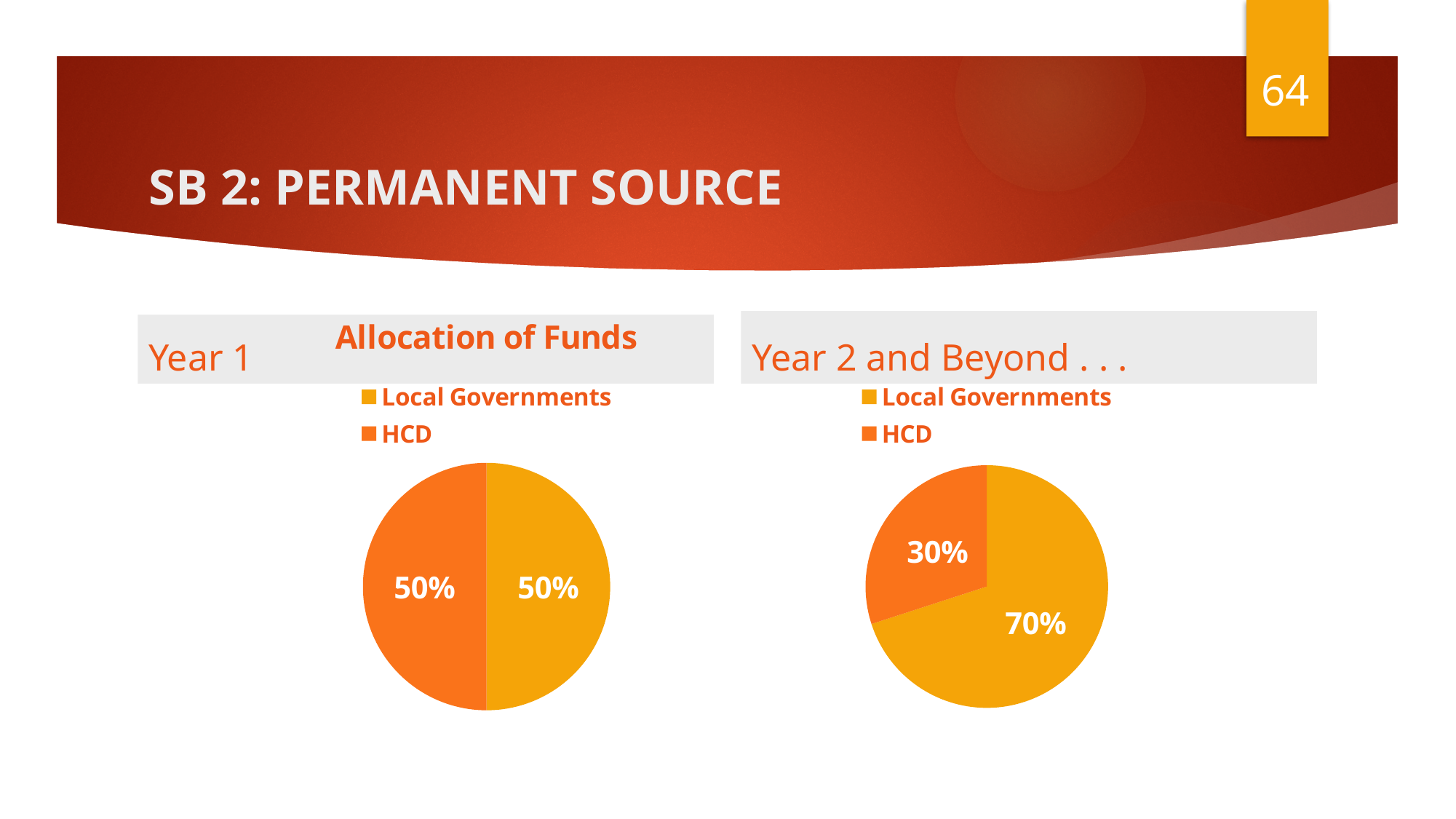
What type of chart is used for the Year 1 allocation? Pie chart How many entries does the legend of the Year 2 and Beyond pie chart list? 2 In the Year 2 and Beyond pie chart, which category receives the smallest share? HCD In the Year 2 and Beyond pie chart, what share of funds goes to HCD? 30% What is the title shown above the Year 1 pie chart? Allocation of Funds In the Year 1 pie chart, what share of funds goes to Local Governments? 50% How many categories does the Year 1 pie chart show? 2 In the Year 2 and Beyond pie chart, which category receives the largest share? Local Governments In the Year 2 and Beyond pie chart, what share of funds goes to Local Governments? 70% In the Year 2 and Beyond pie chart, what is the difference between the Local Governments share and the HCD share? 40% In the Year 1 pie chart, what share of funds goes to HCD? 50% In the Year 2 and Beyond pie chart, which is larger: the Local Governments share or the HCD share? Local Governments